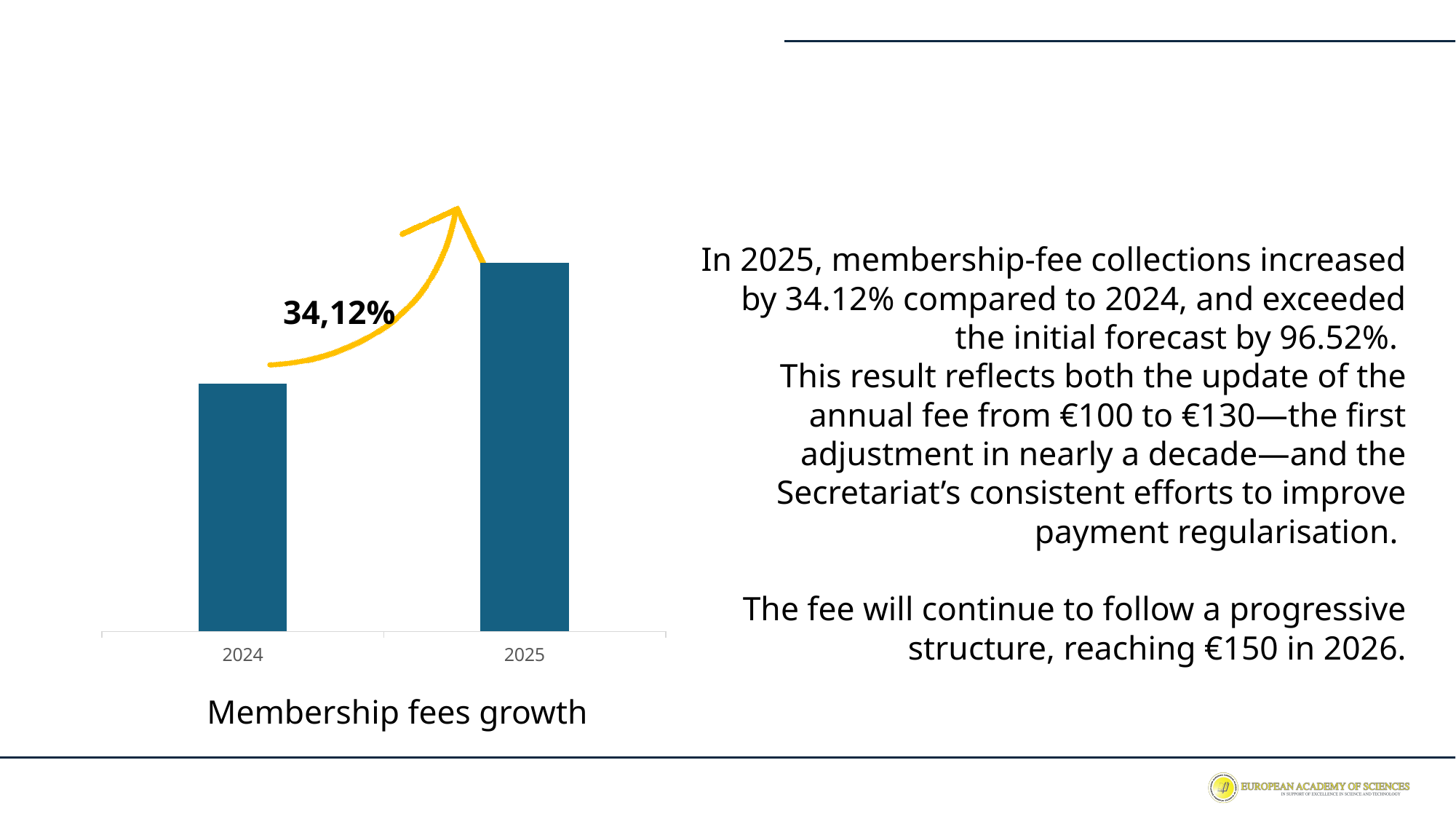
Do the bar values rise or fall from 2024 to 2025? rise How many bars does the chart show? 2 Which year has the shorter bar in the chart? 2024 What kind of chart is shown on the slide? bar chart What is the title of the chart? Membership fees growth Is the bar for 2025 taller or shorter than the bar for 2024? taller Which year has the taller bar in the chart? 2025 What percentage is annotated next to the arrow between the two bars? 34,12%